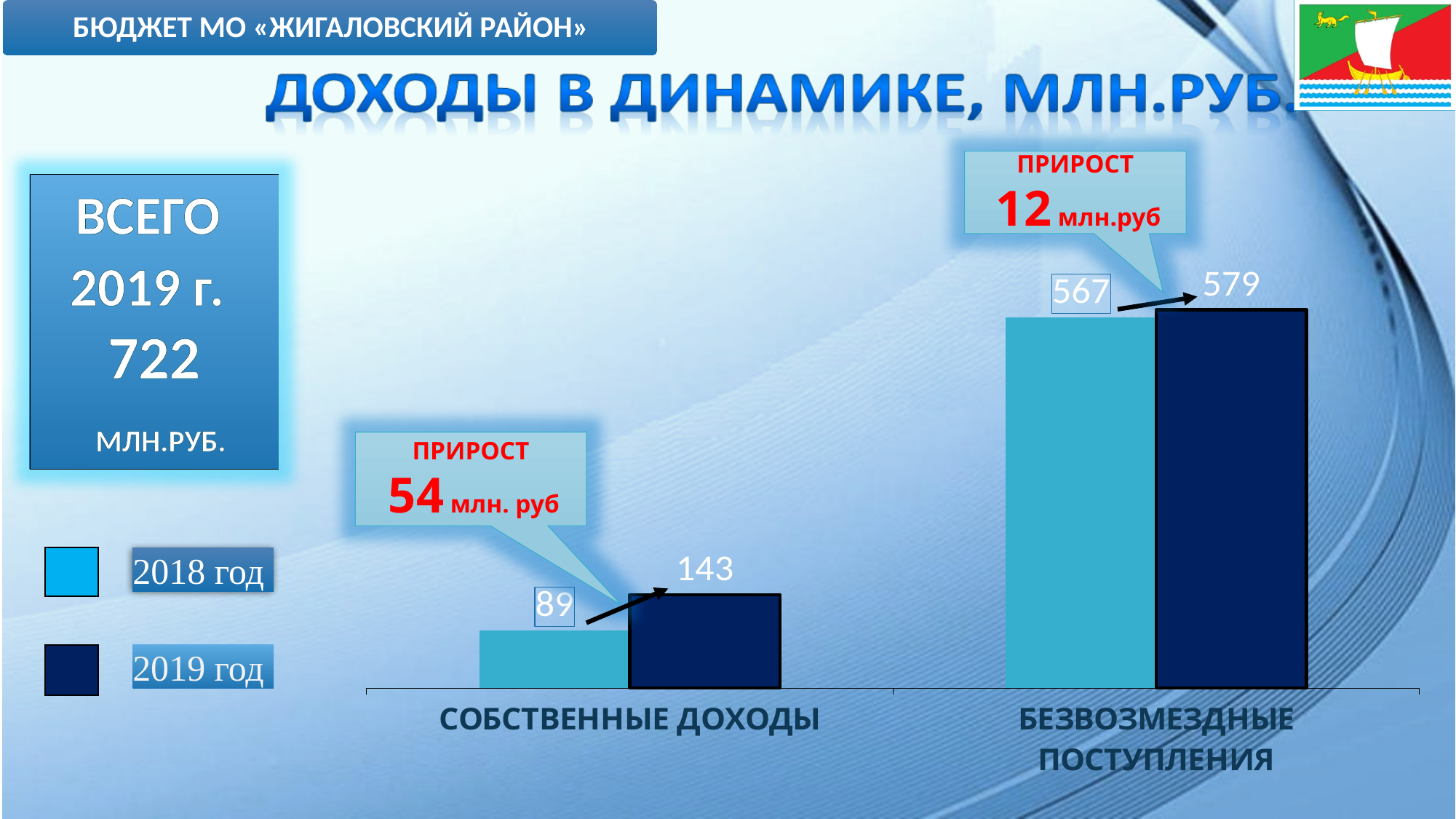
What is the value for СОБСТВЕННЫЕ ДОХОДЫ in 2019 год? 143 What is the difference between the 2019 год and 2018 год values for СОБСТВЕННЫЕ ДОХОДЫ? 54 What is the value for СОБСТВЕННЫЕ ДОХОДЫ in 2018 год? 89 How many series does the legend list? 2 Which is larger: the 2018 год value for БЕЗВОЗМЕЗДНЫЕ ПОСТУПЛЕНИЯ or the 2019 год value for СОБСТВЕННЫЕ ДОХОДЫ? 2018 год value for БЕЗВОЗМЕЗДНЫЕ ПОСТУПЛЕНИЯ Which category has the lowest value in 2018 год? СОБСТВЕННЫЕ ДОХОДЫ What kind of chart is shown on the slide? bar chart How many categories are shown on the x axis of the chart? 2 What is the difference between the 2019 год and 2018 год values for БЕЗВОЗМЕЗДНЫЕ ПОСТУПЛЕНИЯ? 12 What is the value for БЕЗВОЗМЕЗДНЫЕ ПОСТУПЛЕНИЯ in 2018 год? 567 Which category has the highest value in 2019 год? БЕЗВОЗМЕЗДНЫЕ ПОСТУПЛЕНИЯ What is the value for БЕЗВОЗМЕЗДНЫЕ ПОСТУПЛЕНИЯ in 2019 год? 579